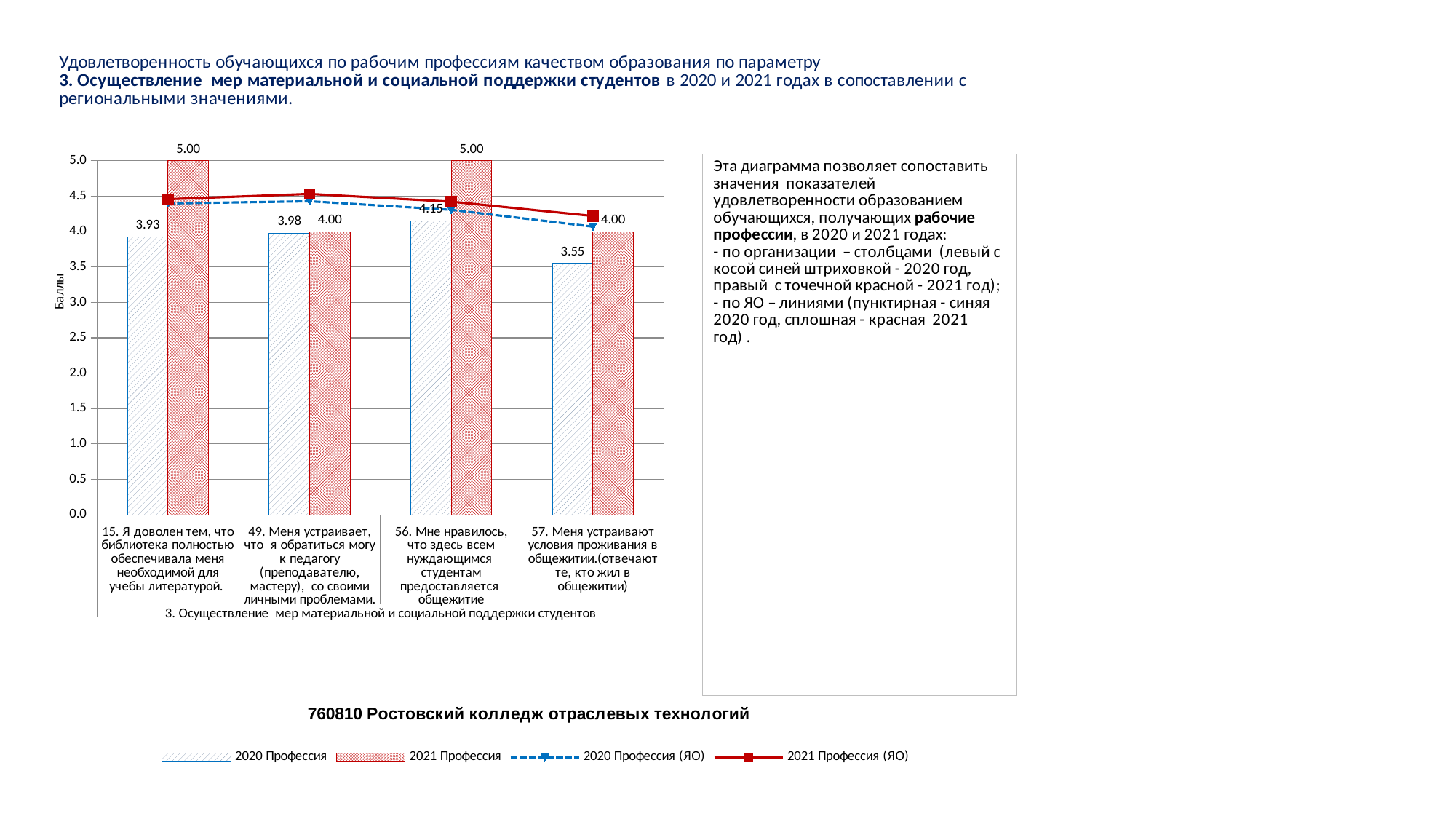
Which question has the lowest 2020 Профессия value? 57. Меня устраивают условия проживания в общежитии What is the 2020 Профессия value for question 57 (Меня устраивают условия проживания в общежитии)? 3.55 What is the label of the vertical axis? Баллы What is the 2021 Профессия value for question 49 (Меня устраивает, что я обратиться могу к педагогу)? 4.00 How many question categories are shown on the x axis? 4 Which question has the highest 2020 Профессия value? 56. Мне нравилось, что здесь всем нуждающимся студентам предоставляется общежитие What is the difference between the 2021 Профессия and 2020 Профессия values for question 57? 0.45 What is the 2021 Профессия value for question 56 (Мне нравилось, что здесь всем нуждающимся студентам предоставляется общежитие)? 5.00 How many series does the legend list? 4 Is the 2020 Профессия (ЯО) line value for question 57 greater or less than 4.5? less For question 15, which is larger: the 2020 Профессия value or the 2021 Профессия value? 2021 Профессия What is the 2020 Профессия value for question 15 (Я доволен тем, что библиотека полностью обеспечивала меня необходимой для учебы литературой)? 3.93